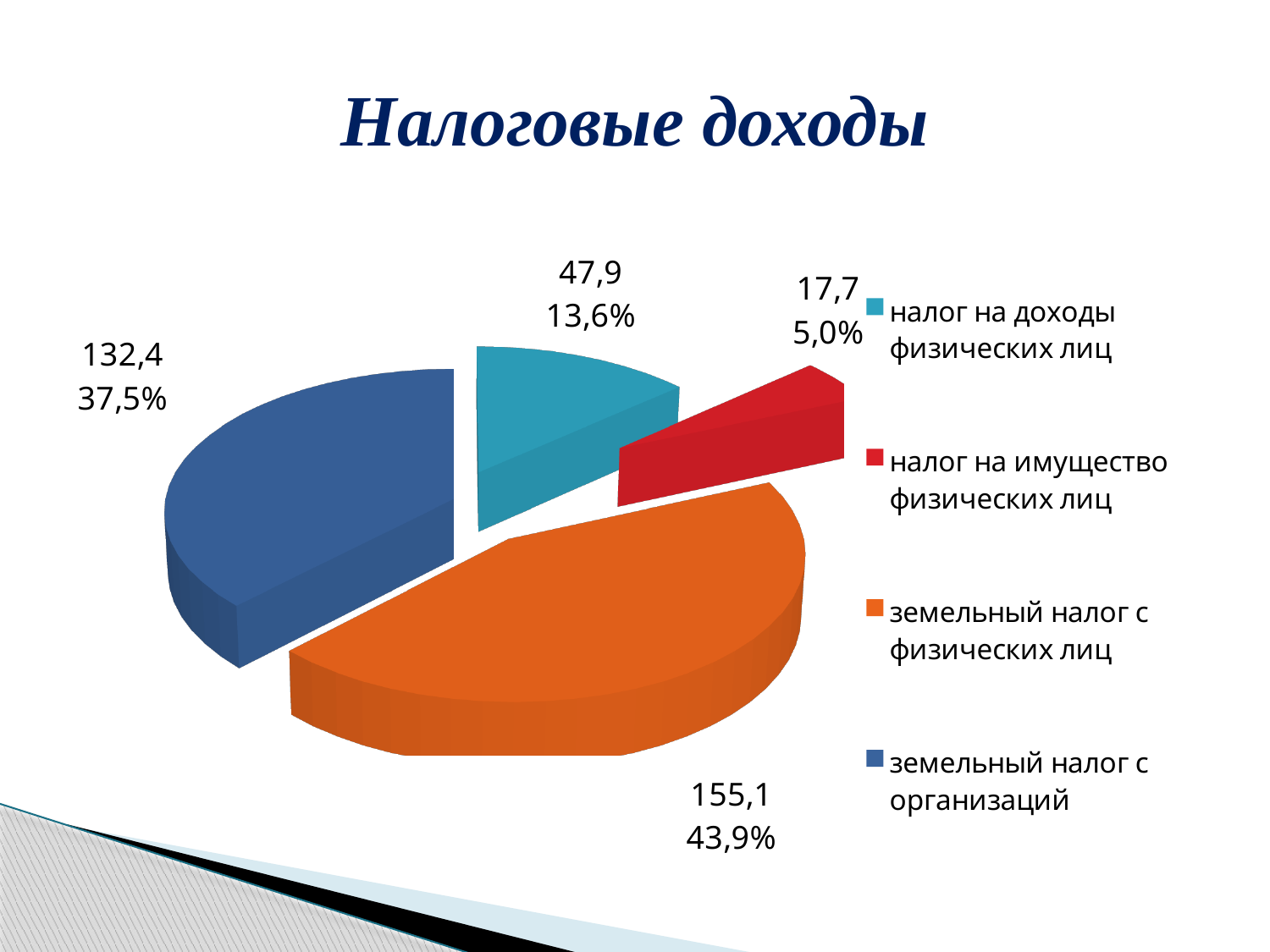
Which is larger, the value for налог на доходы физических лиц or налог на имущество физических лиц? налог на доходы физических лиц What kind of chart is shown on the slide? pie chart What is the difference between the values for земельный налог с физических лиц and земельный налог с организаций? 22,7 What is the value for земельный налог с физических лиц? 155,1 How many slices does the pie chart have? 4 What is the title of the chart? Налоговые доходы What share of the pie does налог на доходы физических лиц take? 13,6% What is the value for налог на доходы физических лиц? 47,9 What share of the pie does земельный налог с организаций take? 37,5% Which category has the largest slice? земельный налог с физических лиц Which category has the smallest slice? налог на имущество физических лиц What is the value for налог на имущество физических лиц? 17,7